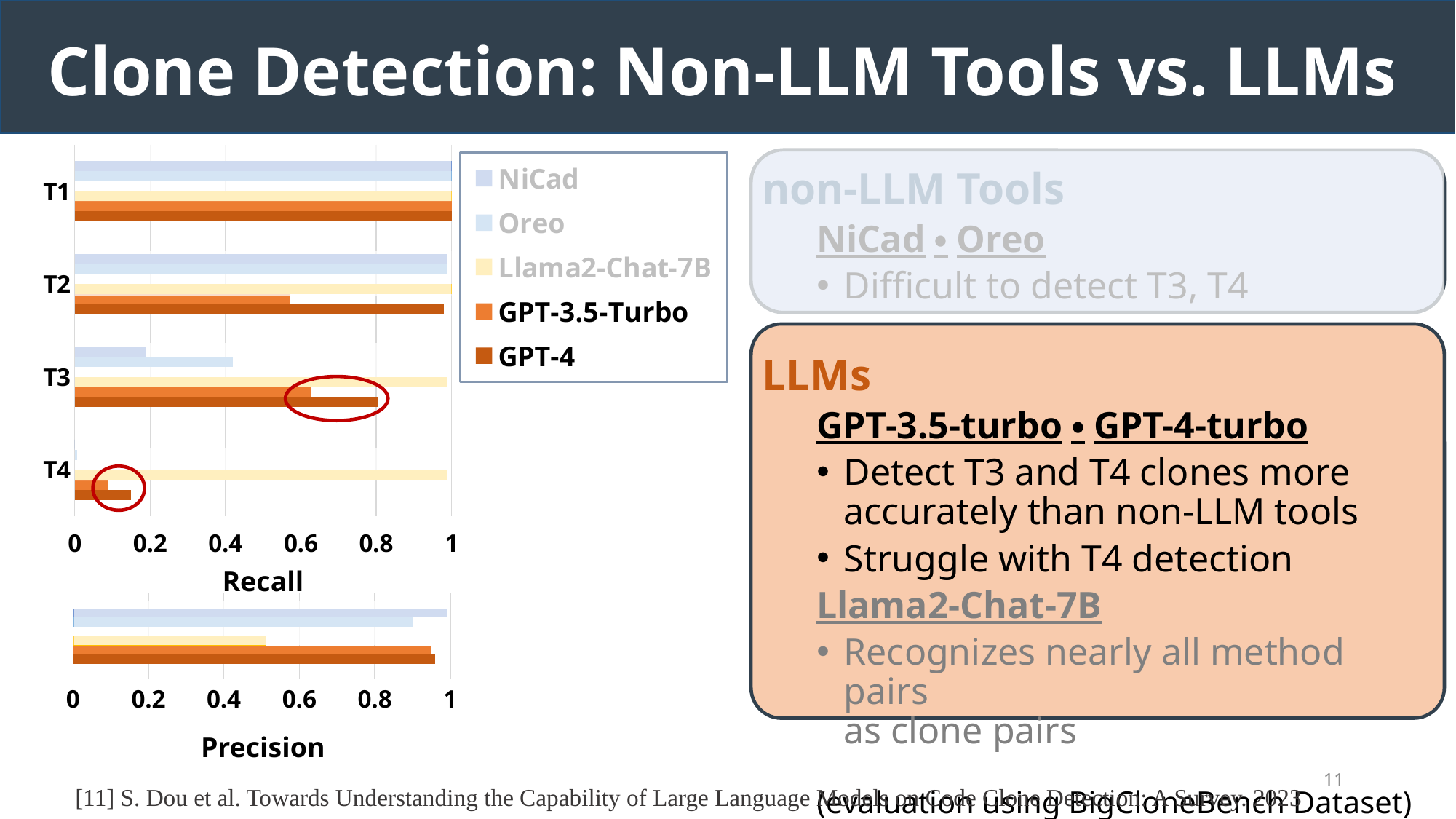
In the Recall chart, which series has the lowest value at T3? NiCad How many series does the legend list? 5 In the Precision chart, is the value for Llama2-Chat-7B greater or less than 0.8? less In the Recall chart, is the value for NiCad at T3 greater or less than 0.4? less In the Recall chart, which has the higher value at T3: Oreo or NiCad? Oreo In the Recall chart, is the value for GPT-3.5-Turbo at T2 greater or less than 0.8? less What kind of chart is the Recall chart? bar chart In the Recall chart, which has the higher value at T3: GPT-4 or GPT-3.5-Turbo? GPT-4 In the Precision chart, which series has the lowest value? Llama2-Chat-7B In the Recall chart, how many categories are shown on the vertical axis? 4